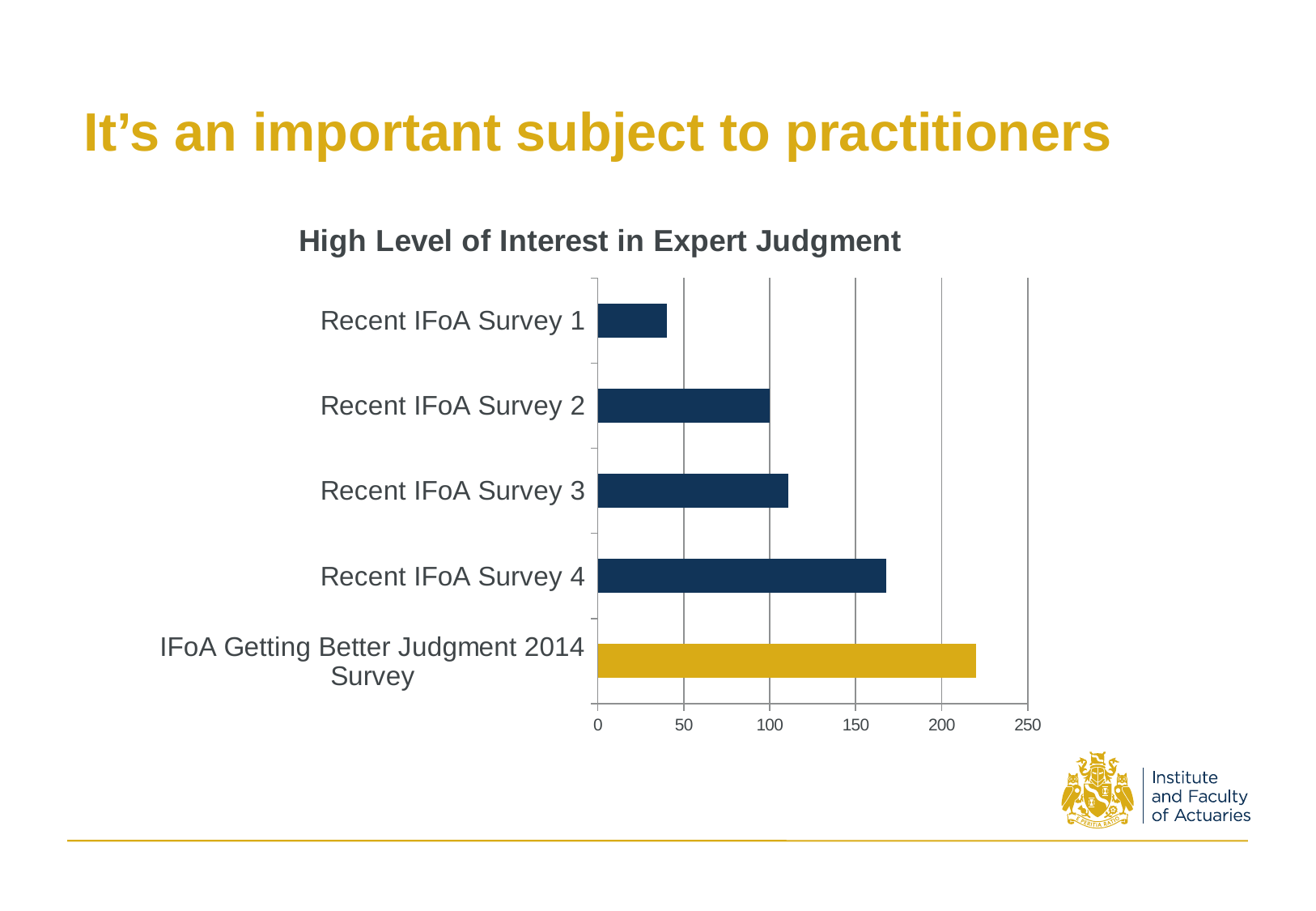
Is the value for Recent IFoA Survey 1 greater or less than 50? less Which category has the lowest value in the chart? Recent IFoA Survey 1 What kind of chart is shown on the slide? Bar chart Do the bar values increase or decrease going from Recent IFoA Survey 1 to Recent IFoA Survey 4? Increase How many categories are plotted in the chart? 5 Is the value for IFoA Getting Better Judgment 2014 Survey greater or less than 200? greater Which has the larger value, Recent IFoA Survey 4 or Recent IFoA Survey 2? Recent IFoA Survey 4 Which category has the highest value in the chart? IFoA Getting Better Judgment 2014 Survey Is the value for Recent IFoA Survey 3 greater or less than 100? greater Which has the larger value, Recent IFoA Survey 3 or Recent IFoA Survey 1? Recent IFoA Survey 3 What is the title of the chart? High Level of Interest in Expert Judgment